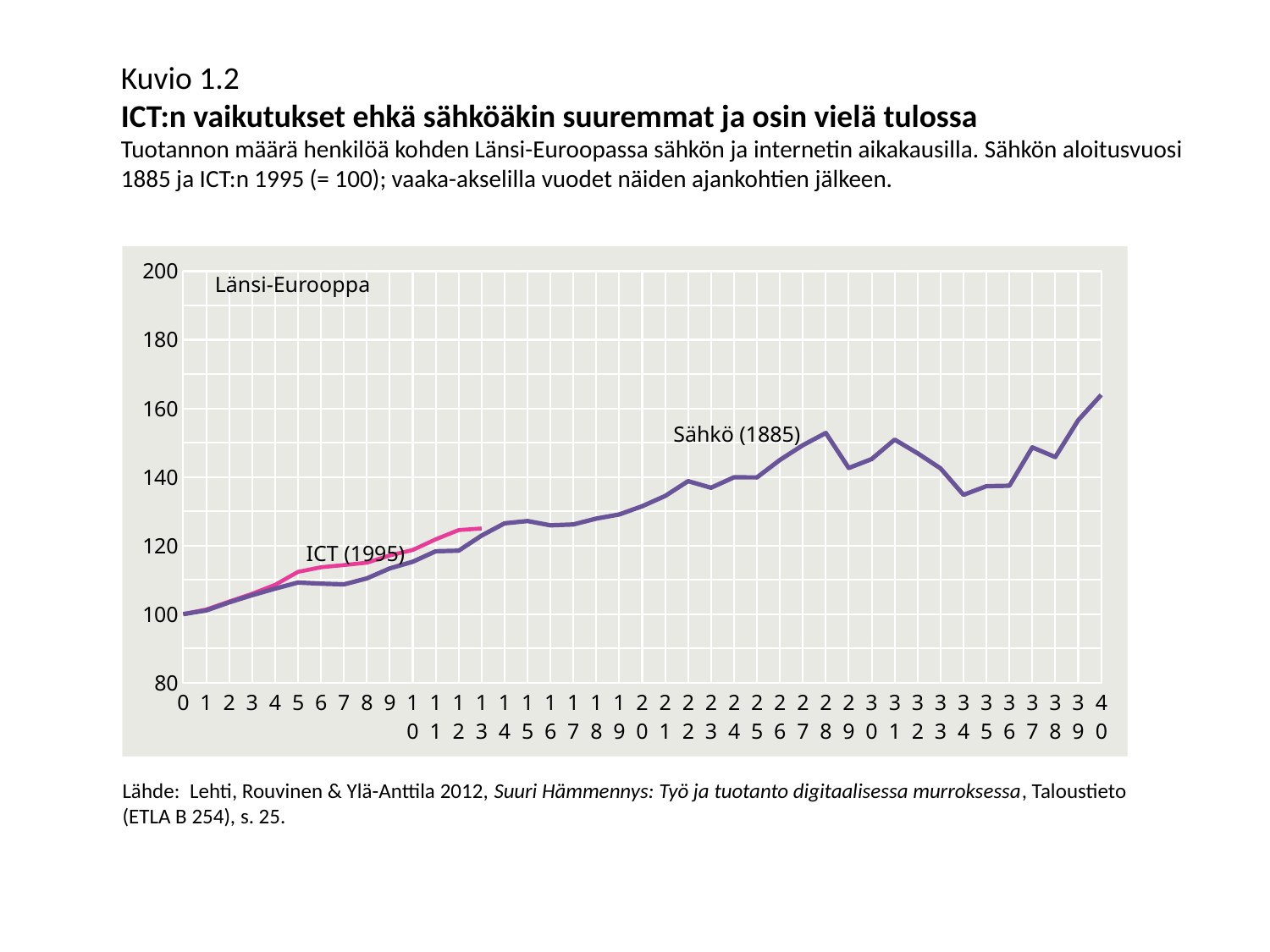
What is the value of the Sähkö (1885) series at year 0 on the x axis? 100 Is the value of the Sähkö (1885) series at year 7 greater or less than 120? less How many series are plotted on the chart? 2 What is the value of the ICT (1995) series at year 0 on the x axis? 100 At year 10 on the x axis, which series has the higher value, ICT (1995) or Sähkö (1885)? ICT (1995) Is the value of the Sähkö (1885) series at year 40 greater or less than 150? greater What kind of chart is shown on the slide? line chart Is the value of the ICT (1995) series at year 13 greater or less than 120? greater What are the names of the two series plotted on the chart? Sähkö (1885) and ICT (1995) At which year on the x axis does the Sähkö (1885) series reach its highest value? 40 Does the Sähkö (1885) series overall rise or fall from year 0 to year 40? rise